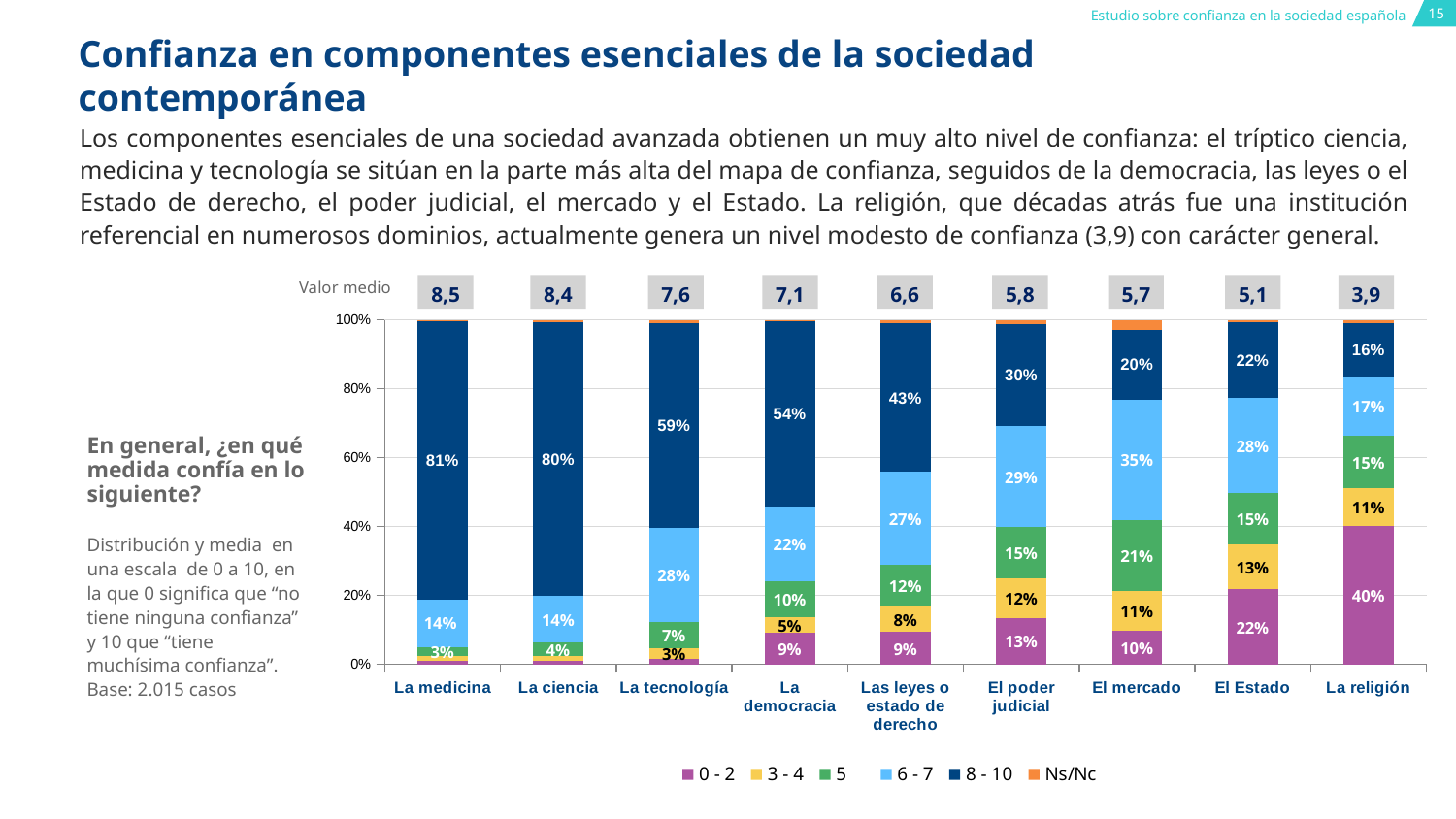
Which category has the lowest mean value (Valor medio)? La religión How many series does the legend list? 6 What is the mean value (Valor medio) shown for 'El poder judicial'? 5,8 What is the difference in percentage points between the 8 - 10 share for 'La democracia' and for 'Las leyes o estado de derecho'? 11 percentage points What percentage of respondents gave 'El Estado' a score of 3 - 4? 13% Which category has the highest share of 8 - 10 scores? La medicina How many categories are shown on the x axis of the chart? 9 Which legend entry is shown in orange? Ns/Nc What percentage of respondents gave 'La medicina' a score of 8 - 10? 81% What percentage of respondents gave 'La religión' a score of 0 - 2? 40% What kind of chart is shown on the slide? Stacked bar chart Which has a larger 6 - 7 share, 'El mercado' or 'El Estado'? El mercado